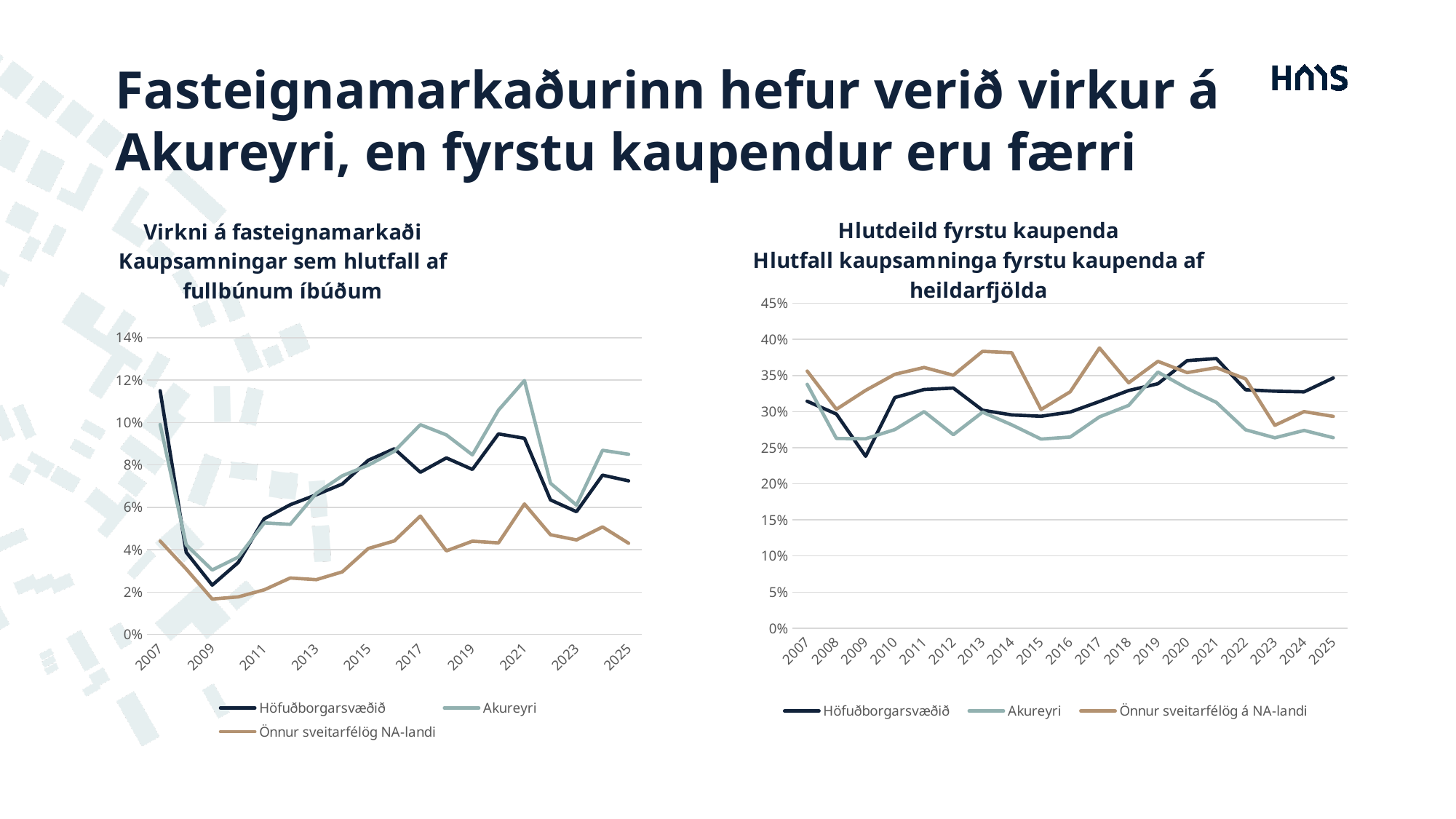
How many series does the legend of the right chart, 'Hlutdeild fyrstu kaupenda', list? 3 In the left chart, 'Virkni á fasteignamarkaði', is the value for Önnur sveitarfélög NA-landi in 2009 greater or less than 2%? less In the right chart, 'Hlutdeild fyrstu kaupenda', is the value for Önnur sveitarfélög á NA-landi in 2017 greater or less than 35%? greater What is the title of the left chart? Virkni á fasteignamarkaði Kaupsamningar sem hlutfall af fullbúnum íbúðum What kind of chart is the left chart, 'Virkni á fasteignamarkaði'? Line chart In the right chart, 'Hlutdeild fyrstu kaupenda', is the value for Höfuðborgarsvæðið in 2009 greater or less than 25%? less In the right chart, 'Hlutdeild fyrstu kaupenda', which series is larger in 2025, Höfuðborgarsvæðið or Akureyri? Höfuðborgarsvæðið In the left chart, 'Virkni á fasteignamarkaði', in which year does the Akureyri series reach its highest value? 2021 In the left chart, 'Virkni á fasteignamarkaði', which series is larger in 2021, Akureyri or Höfuðborgarsvæðið? Akureyri How many years are labelled on the x axis of the right chart, 'Hlutdeild fyrstu kaupenda'? 19 In the right chart, 'Hlutdeild fyrstu kaupenda', in which year does the Höfuðborgarsvæðið series reach its lowest value? 2009